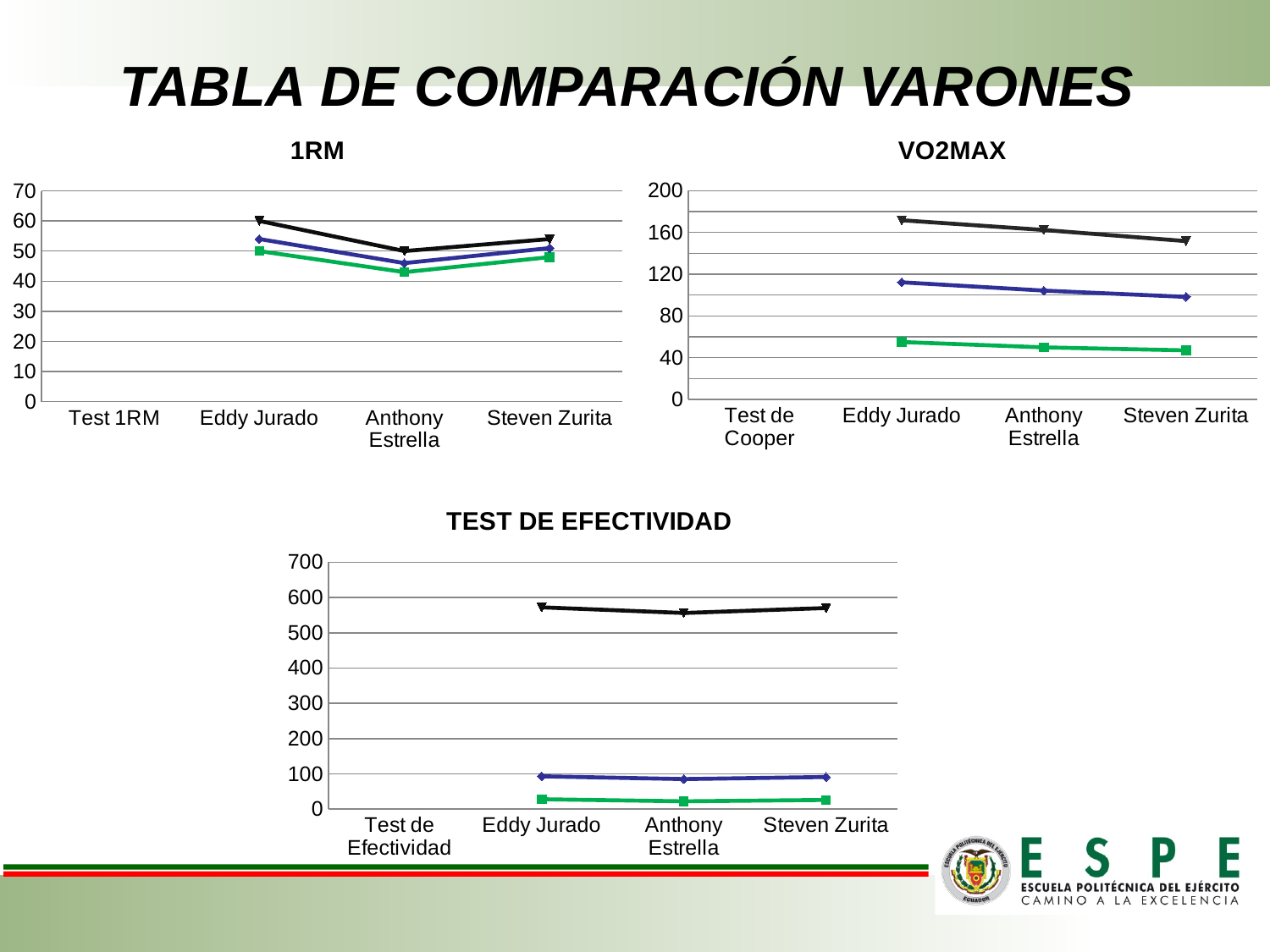
In the VO2MAX chart, is the value of the green line at Eddy Jurado greater or less than 80? less In the TEST DE EFECTIVIDAD chart, is the value of the black line at Anthony Estrella greater or less than 500? greater In the 1RM chart, is the value of the black line at Eddy Jurado greater or less than 50? greater In the 1RM chart, how many category labels are shown on the x axis? 4 In the VO2MAX chart, what is the highest value shown on the y axis? 200 In the VO2MAX chart, is the black line higher at Eddy Jurado or at Steven Zurita? Eddy Jurado In the VO2MAX chart, does the black line rise or fall from Eddy Jurado to Steven Zurita? fall In the TEST DE EFECTIVIDAD chart, how many lines are plotted? 3 In the 1RM chart, at which category does the black line reach its lowest point? Anthony Estrella In the 1RM chart, what kind of chart is shown? line chart What is the title of the chart at the bottom of the slide? TEST DE EFECTIVIDAD